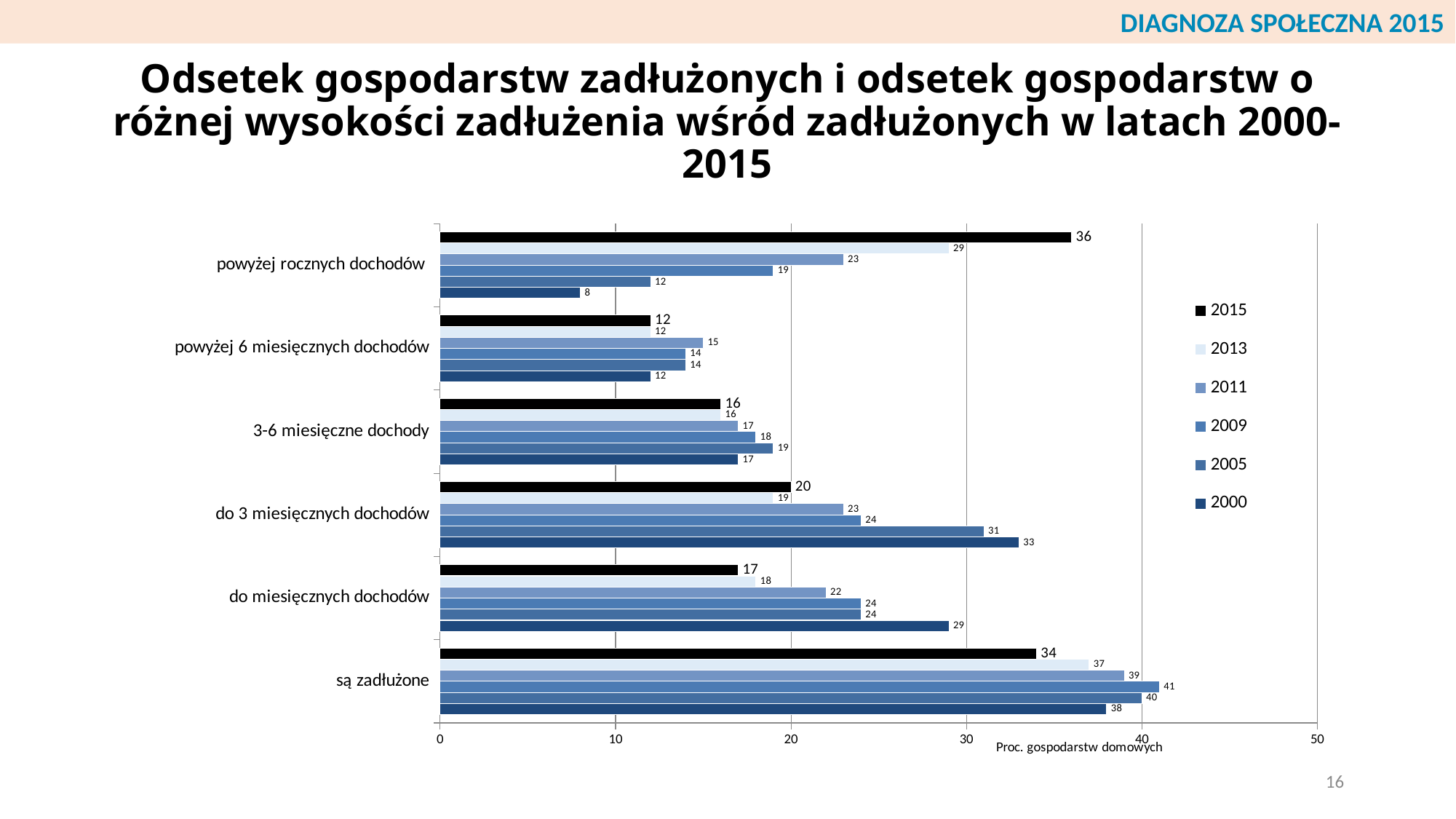
What kind of chart is shown on the slide? bar chart What is the value for 2000 in the category "są zadłużone"? 38 What is the value for 2015 in the category "powyżej rocznych dochodów"? 36 How many categories are shown on the vertical axis of the chart? 6 How many series does the legend list? 6 Which year has the highest value in the category "są zadłużone"? 2009 What is the value for 2005 in the category "do 3 miesięcznych dochodów"? 31 Is the value for 2013 in the category "są zadłużone" greater or less than 30? greater In the category "do miesięcznych dochodów", which is larger: the value for 2000 or the value for 2015? 2000 Which year has the lowest value in the category "powyżej rocznych dochodów"? 2000 What is the label of the horizontal axis of the chart? Proc. gospodarstw domowych What is the difference between the 2015 and 2000 values in the category "powyżej rocznych dochodów"? 28